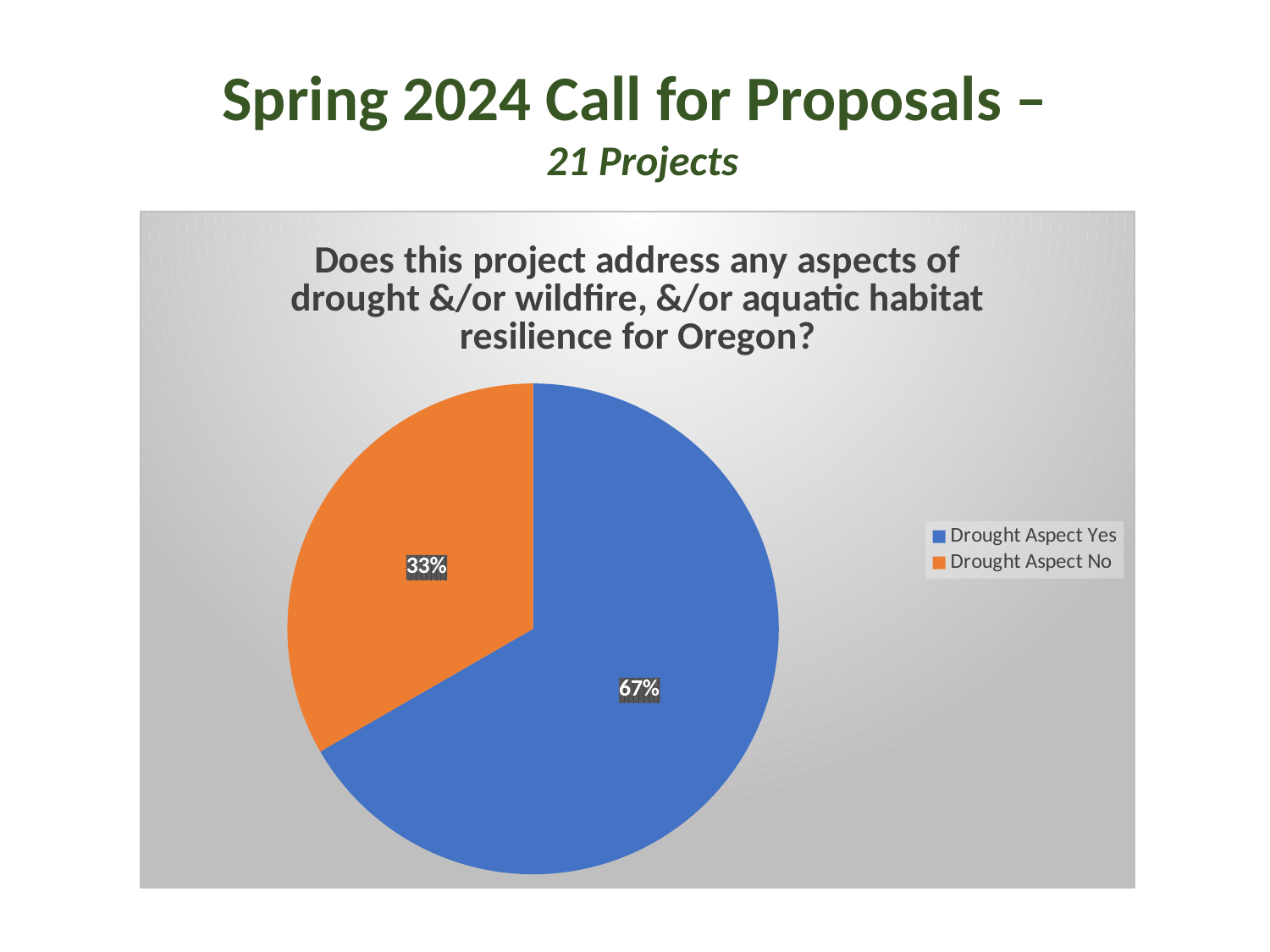
How many entries does the legend list? 2 What share of the pie is labelled Drought Aspect No? 33% Which slice of the pie is the smallest? Drought Aspect No Which is larger, the Drought Aspect Yes slice or the Drought Aspect No slice? Drought Aspect Yes How many slices does the pie chart have? 2 What share of the pie is labelled Drought Aspect Yes? 67% What is the difference in percentage points between the Drought Aspect Yes and Drought Aspect No slices? 34 What is the title of the pie chart? Does this project address any aspects of drought &/or wildfire, &/or aquatic habitat resilience for Oregon? What colour is the Drought Aspect No slice? orange What type of chart is shown on the slide? pie chart Which slice of the pie is the largest? Drought Aspect Yes